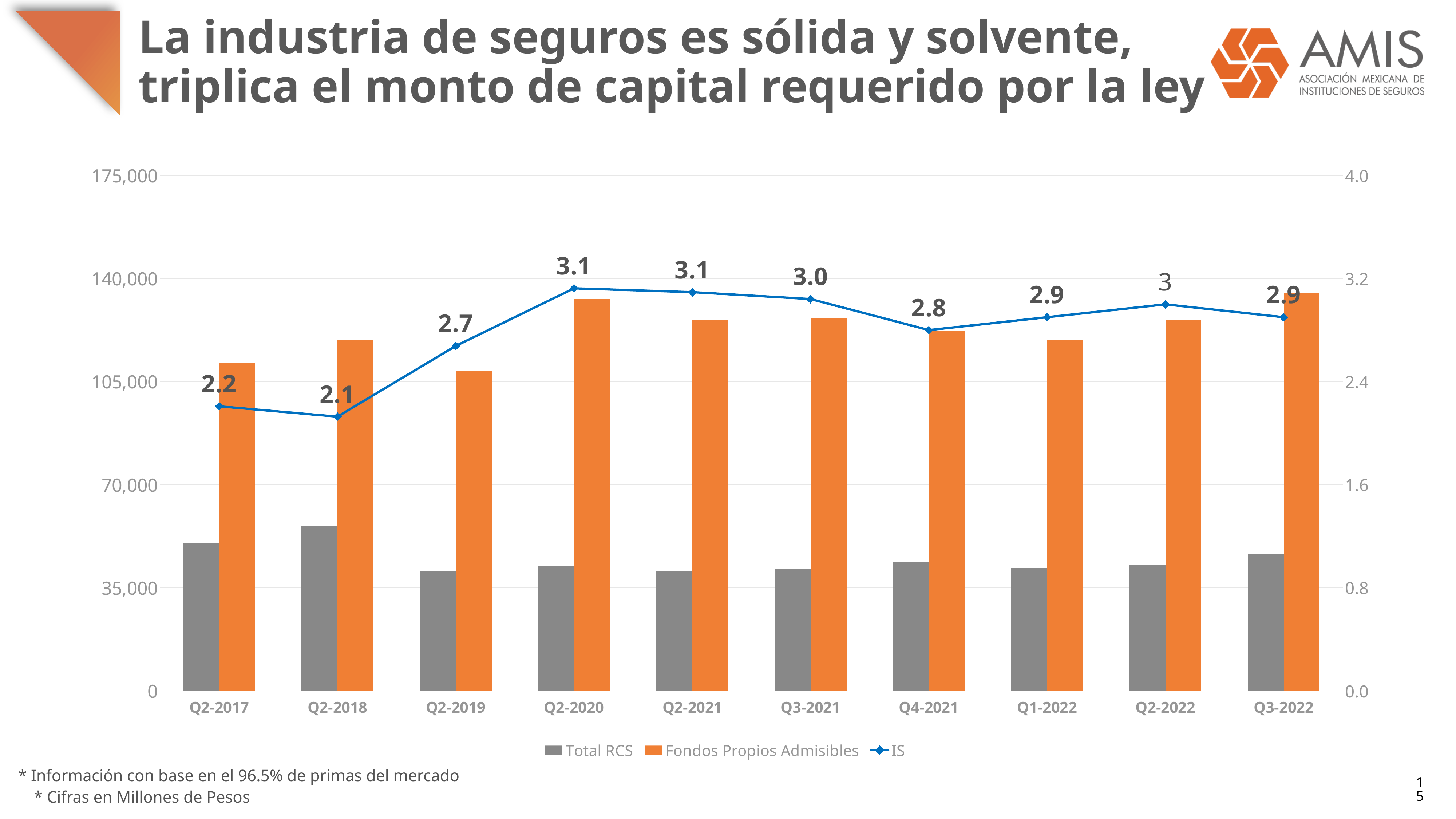
What kind of chart is shown on the slide? Combination bar and line chart Is the Total RCS value for Q2-2018 greater or less than 70,000? less Which has a higher IS value, Q2-2019 or Q4-2021? Q4-2021 How many periods are shown on the x axis? 10 What is the IS value for Q2-2017? 2.2 In which period is the IS value lowest? Q2-2018 What is the IS value for Q2-2022? 3 What is the IS value for Q2-2019? 2.7 How many series does the legend list? 3 Is the Fondos Propios Admisibles value for Q2-2020 greater or less than 140,000? less Does the IS value rise or fall from Q2-2018 to Q2-2020? rise What is the difference between the IS value for Q2-2020 and the IS value for Q2-2017? 0.9